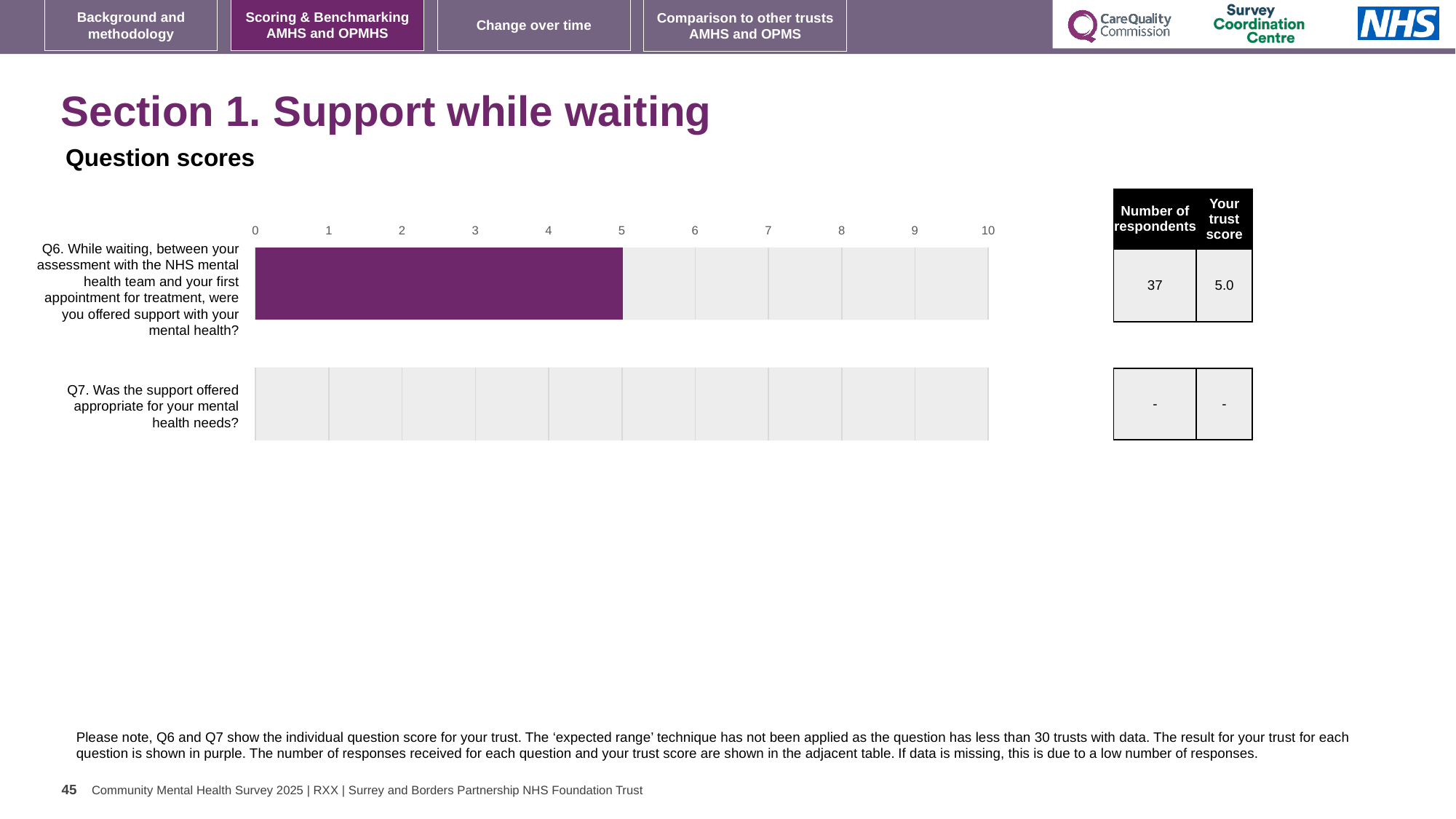
What kind of chart is shown on the slide? bar chart What is the trust score plotted for Q6 on the chart? 5.0 Which question on the chart has the higher plotted score? Q6 Is the value for Q6 greater or less than 8? less How many questions (categories) are listed on the chart? 2 Which question on the chart has no bar plotted? Q7 What colour is the bar for Q6? purple What is the highest value shown on the chart's horizontal axis? 10 Is the value for Q6 greater or less than 4? greater